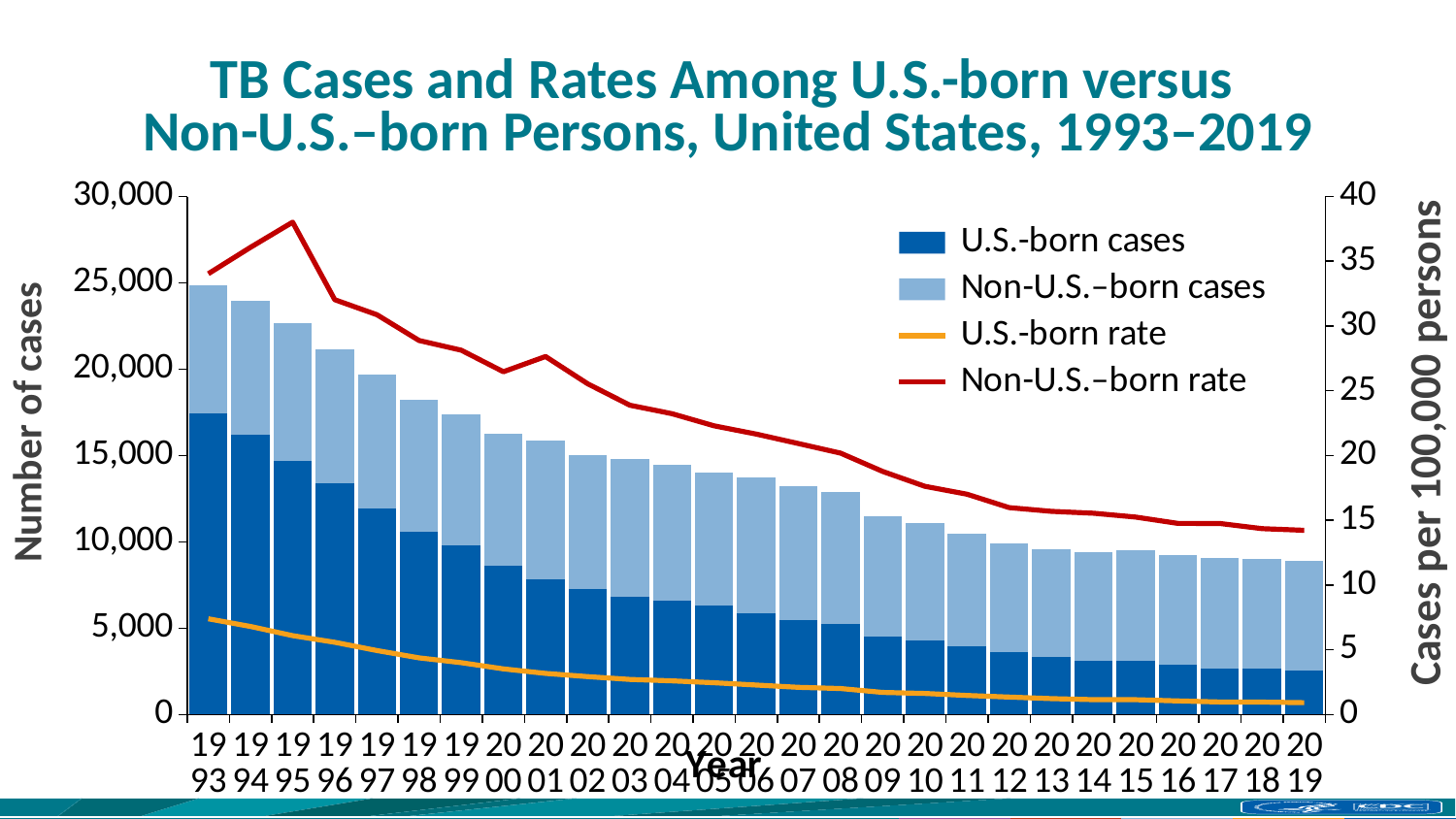
Is the value for U.S.-born cases in 1993 greater or less than 15,000? greater In which year is the Non-U.S.-born rate highest? 1995 Is the Non-U.S.-born rate in 2019 greater or less than 15? less Is the value for U.S.-born cases in 2019 greater or less than 5,000? less In 1993, which is larger: U.S.-born cases or Non-U.S.-born cases? U.S.-born cases How many years are shown along the x axis? 27 Do U.S.-born cases rise or fall from 1993 to 2019? fall In 2019, which is larger: U.S.-born cases or Non-U.S.-born cases? Non-U.S.-born cases In which year is the total number of TB cases (U.S.-born plus Non-U.S.-born) highest? 1993 What kind of chart is used to show the number of cases? stacked bar chart How many series does the legend list? 4